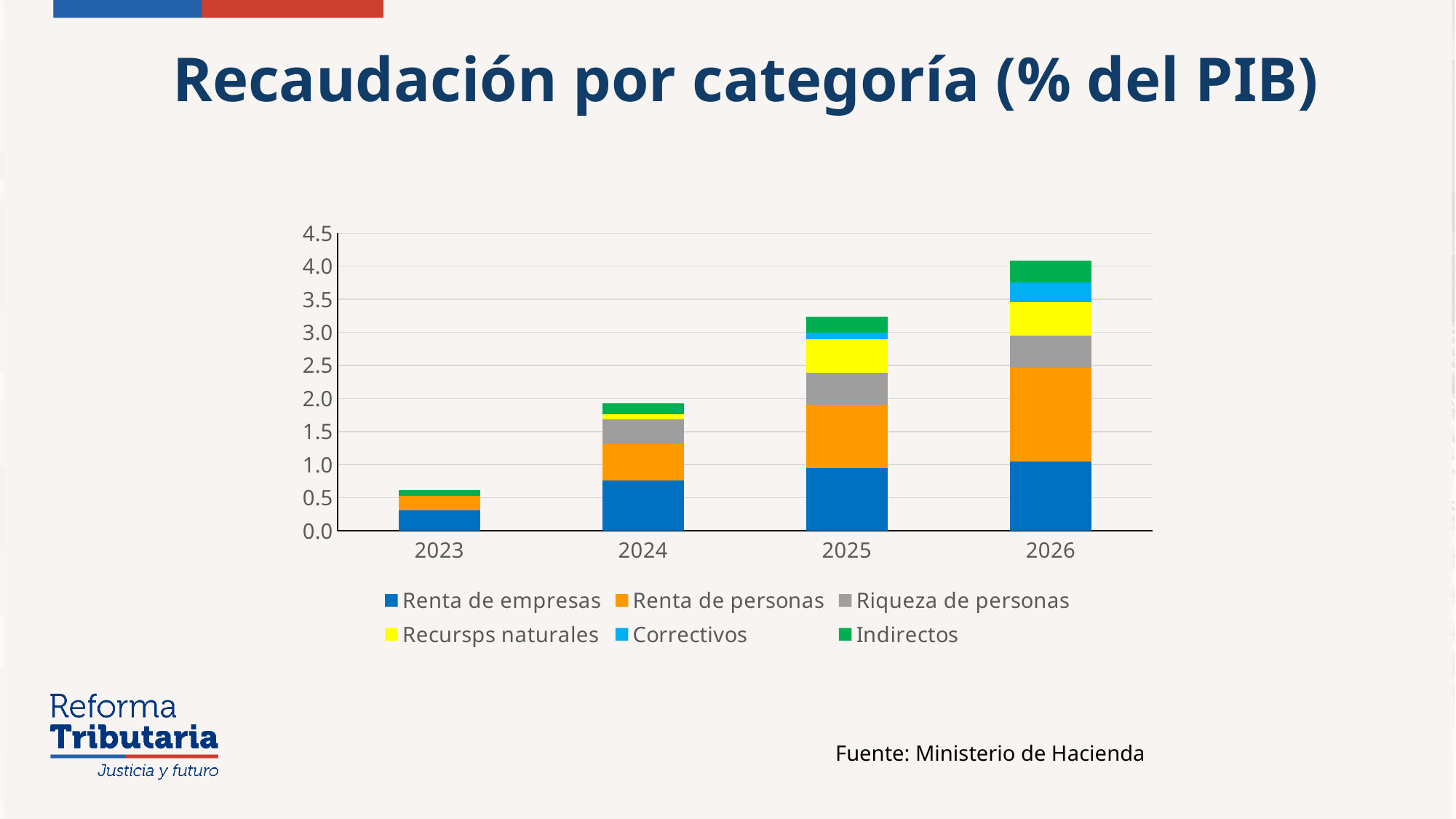
Is the Renta de empresas segment for 2024 greater or less than 0.5? greater Which year has the highest total stacked bar? 2026 Do the total bar heights rise or fall from 2023 to 2026? Rise What kind of chart is shown on the slide? Stacked bar chart Is the total stacked bar for 2026 greater or less than 3.5? greater How many years are shown on the x axis of the chart? 4 Is the total stacked bar for 2023 greater or less than 1.0? less What is the title of the chart on the slide? Recaudación por categoría (% del PIB) How many series does the legend list? 6 Which is larger, the total bar for 2025 or the total bar for 2024? 2025 Which year has the lowest total stacked bar? 2023